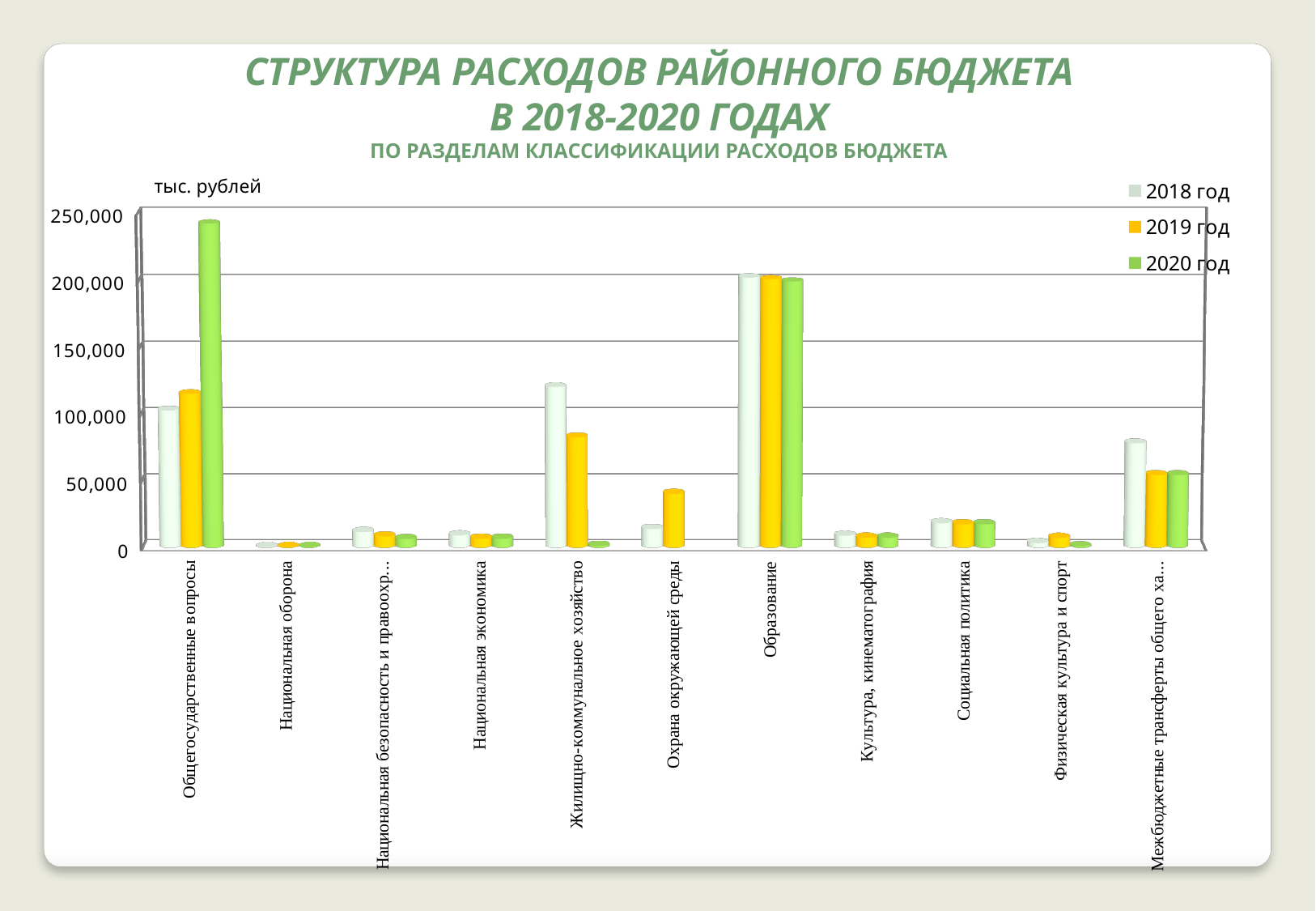
Which category has the lowest value for the 2018 год series? Национальная оборона Which category has the highest value for the 2018 год series? Образование How many expenditure categories are shown along the x axis? 11 What kind of chart is shown on the slide? Bar chart Is the 2019 год value for Жилищно-коммунальное хозяйство greater or less than 100,000? less Is the 2020 год value for Общегосударственные вопросы greater or less than 200,000? greater How many series does the legend list? 3 Do the values for Общегосударственные вопросы rise or fall from 2018 год to 2020 год? Rise What unit label is shown above the vertical axis? тыс. рублей Is the 2019 год value for Охрана окружающей среды greater or less than 50,000? less For Жилищно-коммунальное хозяйство, which is larger: the 2018 год value or the 2019 год value? 2018 год Which category has the highest value for the 2020 год series? Общегосударственные вопросы